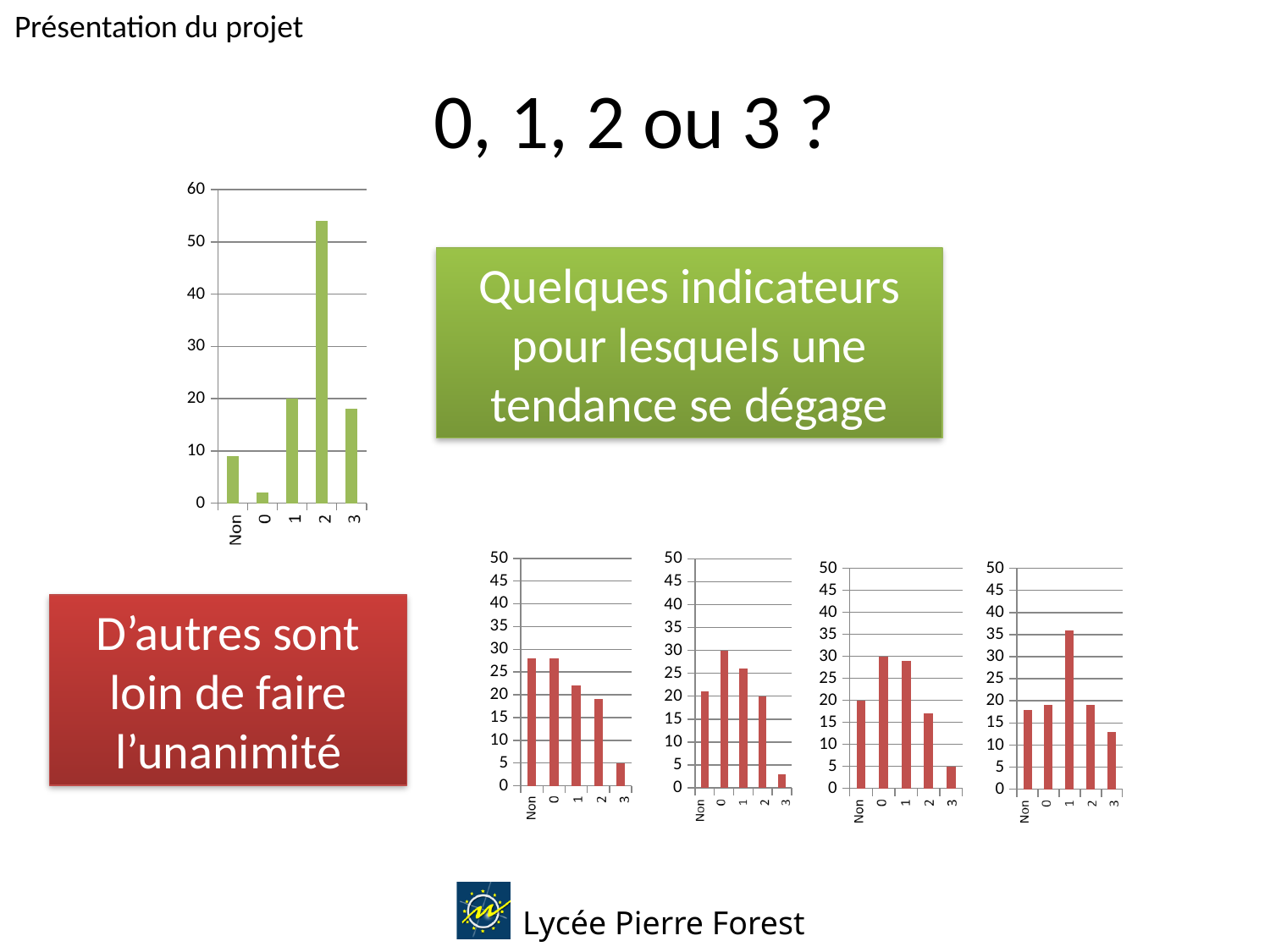
What kind of chart is the green chart at the top left of the slide? bar chart In the green chart at the top left, is the value for Non greater or less than 10? less In the rightmost red chart at the bottom, which category has the highest bar? 1 In the green chart at the top left, which category has the lowest bar? 0 In the rightmost red chart at the bottom, which is larger, the value for 1 or the value for 3? 1 In the leftmost red chart at the bottom, is the value for 3 greater or less than 10? less In the green chart at the top left, which category has the highest bar? 2 In the leftmost red chart at the bottom, which category has the lowest bar? 3 In the second red chart from the left at the bottom, which category has the highest bar? 0 In the green chart at the top left, is the value for 2 greater or less than 50? greater How many categories are shown on the x axis of the green chart at the top left? 5